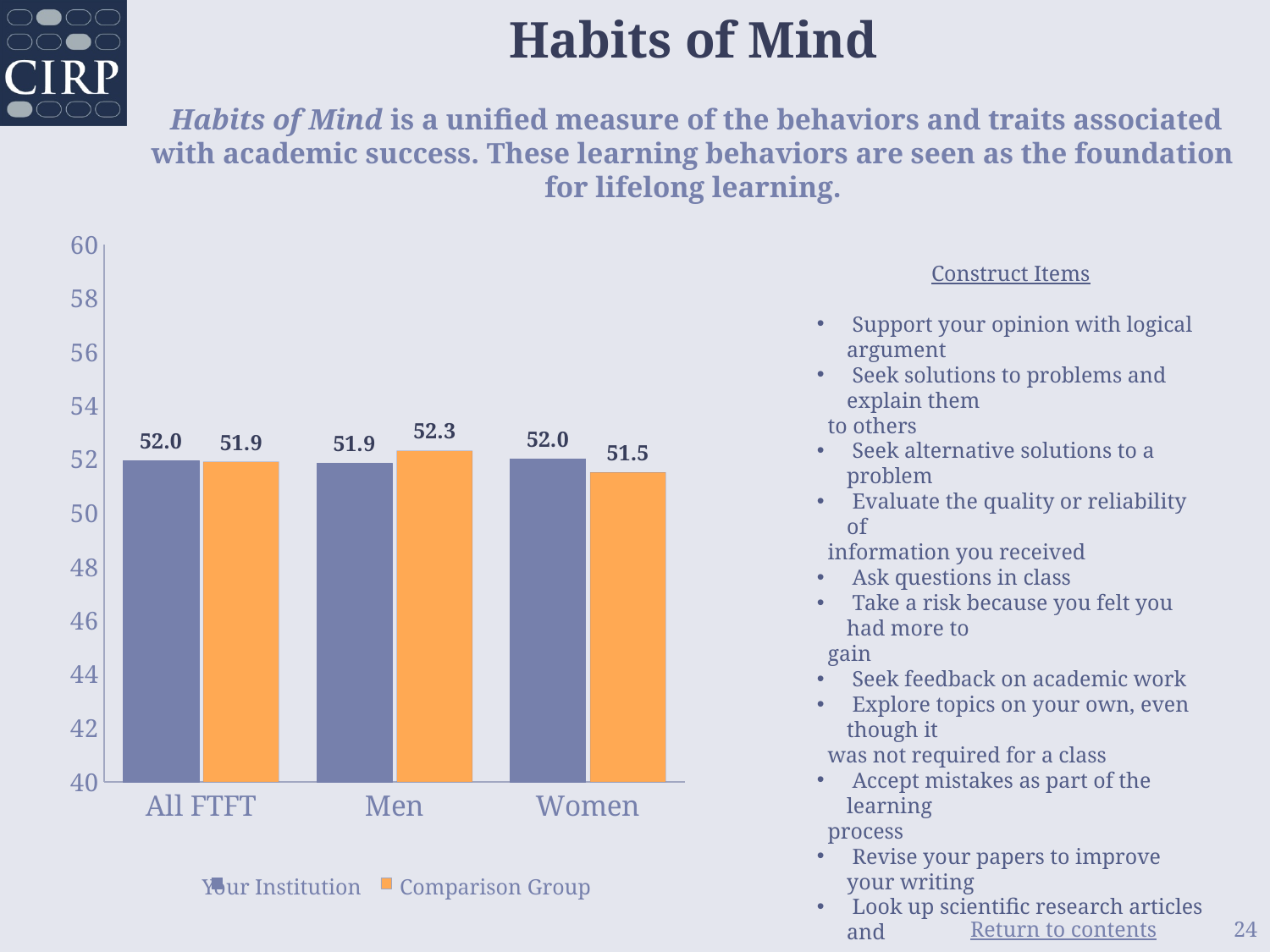
How many categories are shown on the x axis? 3 In the Men category, which is larger: Your Institution or the Comparison Group? Comparison Group How many series does the legend list? 2 What is the value for Your Institution in the All FTFT category? 52.0 What is the value for Your Institution in the Men category? 51.9 What is the value for the Comparison Group in the Men category? 52.3 What is the value for the Comparison Group in the Women category? 51.5 Which category has the highest Comparison Group value? Men What colour are the Comparison Group bars? Orange What is the difference between Your Institution and the Comparison Group in the Women category? 0.5 What kind of chart is shown on the slide? Bar chart Which category has the lowest Comparison Group value? Women